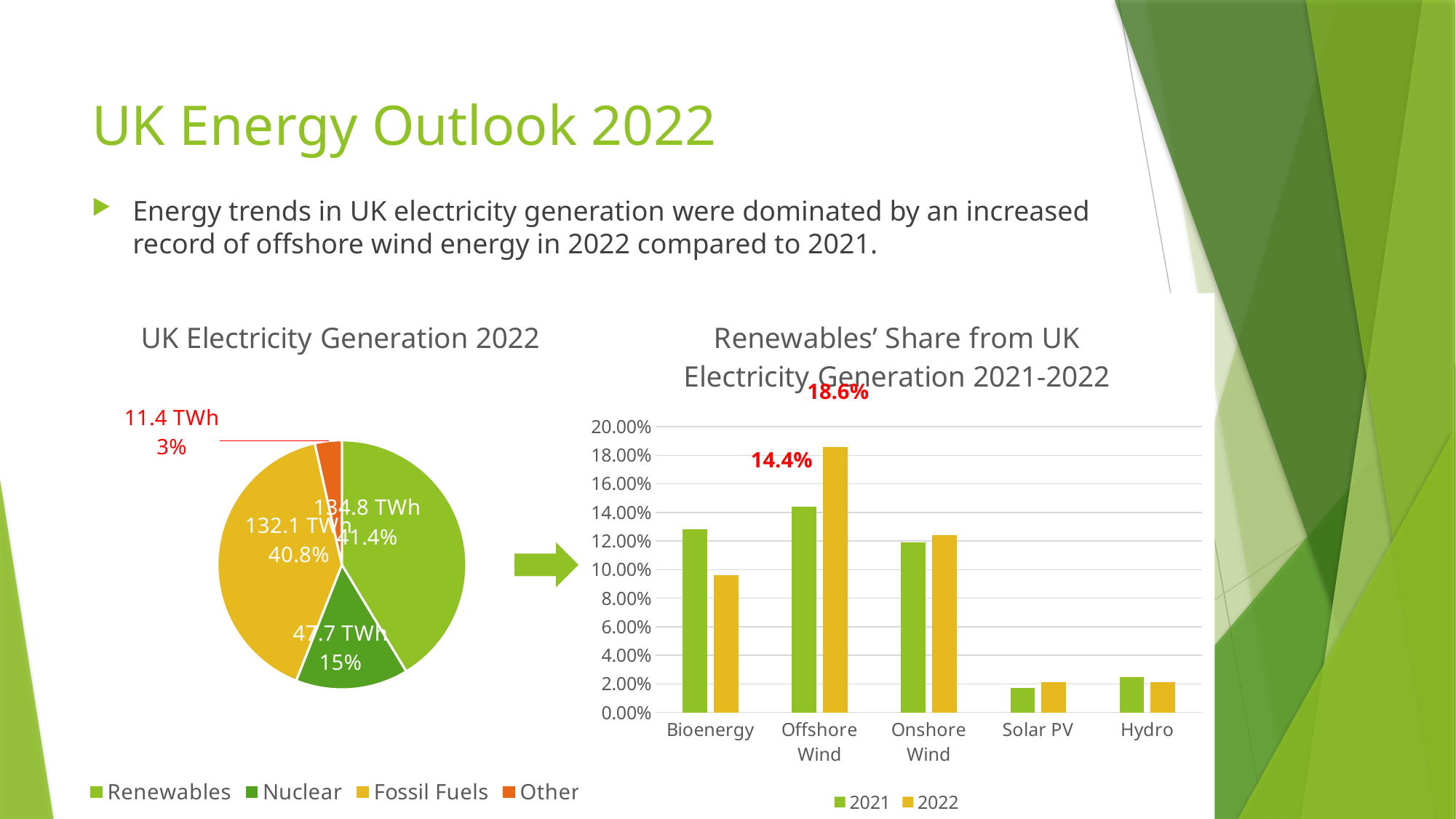
In the UK Electricity Generation 2022 pie chart, what share of the pie does Fossil Fuels have? 40.8% In the UK Electricity Generation 2022 pie chart, what is the difference in TWh between Renewables and Fossil Fuels? 2.7 TWh In the Renewables' Share from UK Electricity Generation 2021-2022 chart, which is larger for Bioenergy: the 2021 value or the 2022 value? 2021 In the UK Electricity Generation 2022 pie chart, which category has the smallest slice? Other In the Renewables' Share from UK Electricity Generation 2021-2022 chart, how many series does the legend list? 2 In the Renewables' Share from UK Electricity Generation 2021-2022 chart, is the 2022 value for Bioenergy greater or less than 10.00%? less In the Renewables' Share from UK Electricity Generation 2021-2022 chart, what is the 2022 value for Offshore Wind? 18.6% In the Renewables' Share from UK Electricity Generation 2021-2022 chart, by how much did Offshore Wind's share increase from 2021 to 2022? 4.2% What type of chart is the Renewables' Share from UK Electricity Generation 2021-2022 chart? Bar chart In the UK Electricity Generation 2022 pie chart, how many categories does the legend list? 4 What type of chart is the UK Electricity Generation 2022 chart? Pie chart In the UK Electricity Generation 2022 pie chart, what is the value for Nuclear? 47.7 TWh